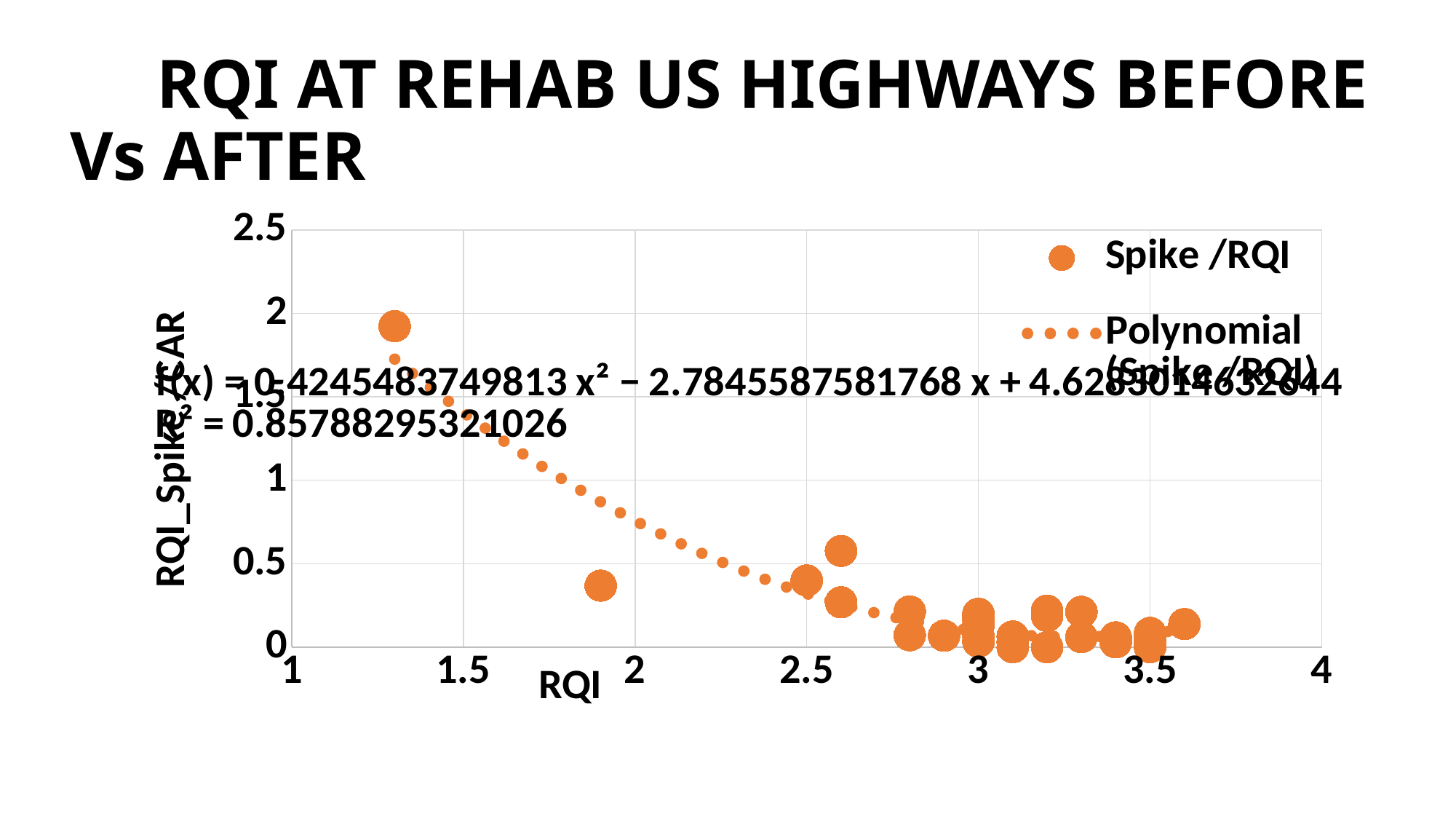
What is the label of the x axis? RQI Do the Spike /RQI values generally rise or fall as RQI increases along the x axis? Fall Is the Spike /RQI value for the point near RQI 1.3 greater or less than 2? less What is the maximum value shown on the y axis? 2.5 Is the highest plotted Spike /RQI value greater or less than 1.5? greater What R² value is printed for the polynomial trendline? 0.85788295321026 What kind of chart is shown on the slide? Scatter chart What is the title of the chart? RQI AT REHAB US HIGHWAYS BEFORE Vs AFTER What are the two entries in the chart legend? Spike /RQI and Polynomial (Spike /RQI) Is the Spike /RQI value for the point near RQI 1.9 greater or less than 0.5? less How many series does the legend list? 2